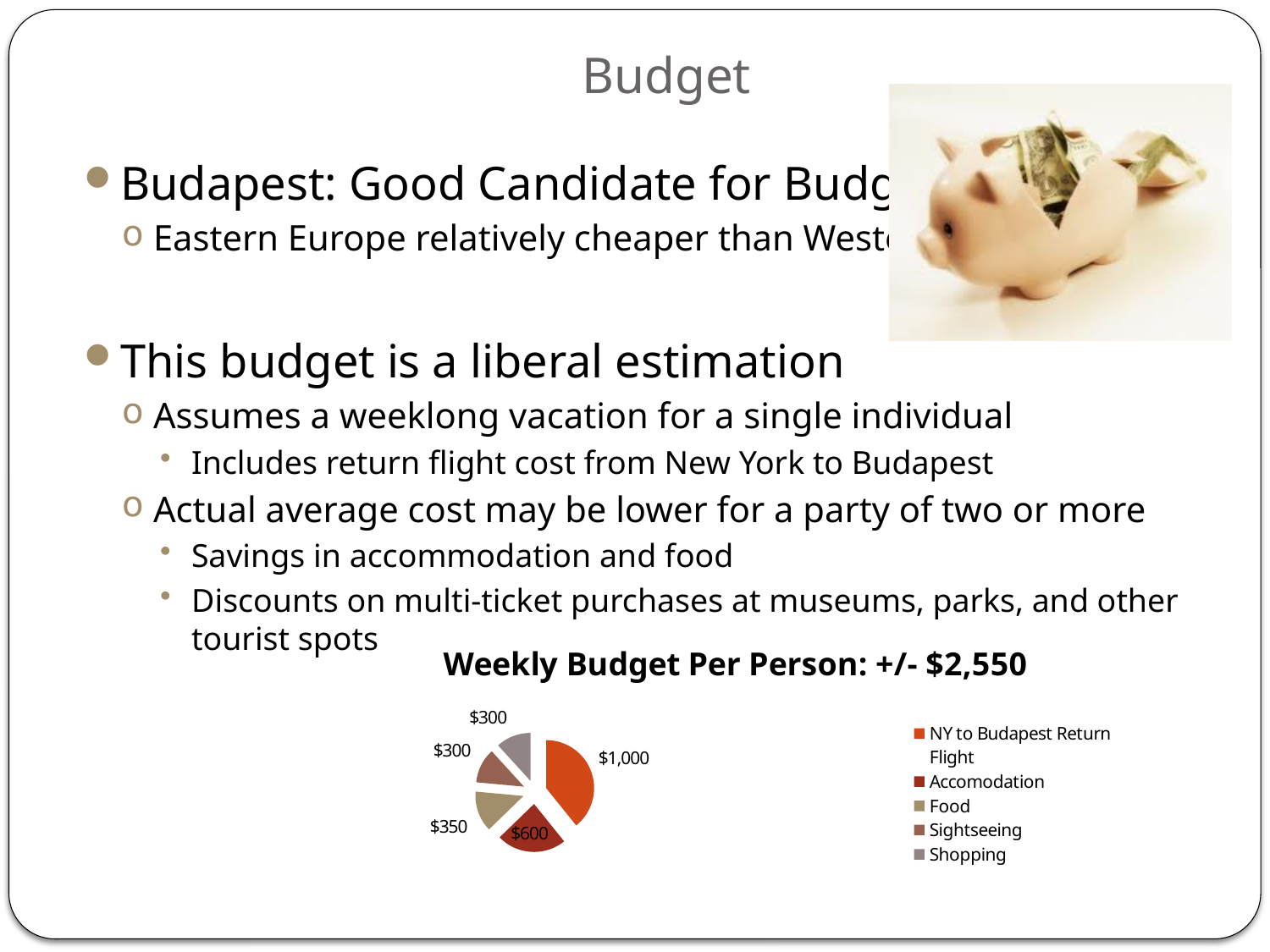
How many slices does the pie chart have? 5 Which is larger, the Accomodation slice or the Food slice? Accomodation What is the total of all the slices in the pie chart? $2,550 What is the value of the NY to Budapest Return Flight slice? $1,000 Which category has the largest slice in the pie chart? NY to Budapest Return Flight What is the difference between the Food value and the Shopping value? $50 What is the value of the Food slice? $350 What is the difference between the NY to Budapest Return Flight value and the Accomodation value? $400 What is the title of the chart? Weekly Budget Per Person: +/- $2,550 How many categories does the legend of the pie chart list? 5 What kind of chart is shown on the slide? pie chart What is the value of the Accomodation slice? $600